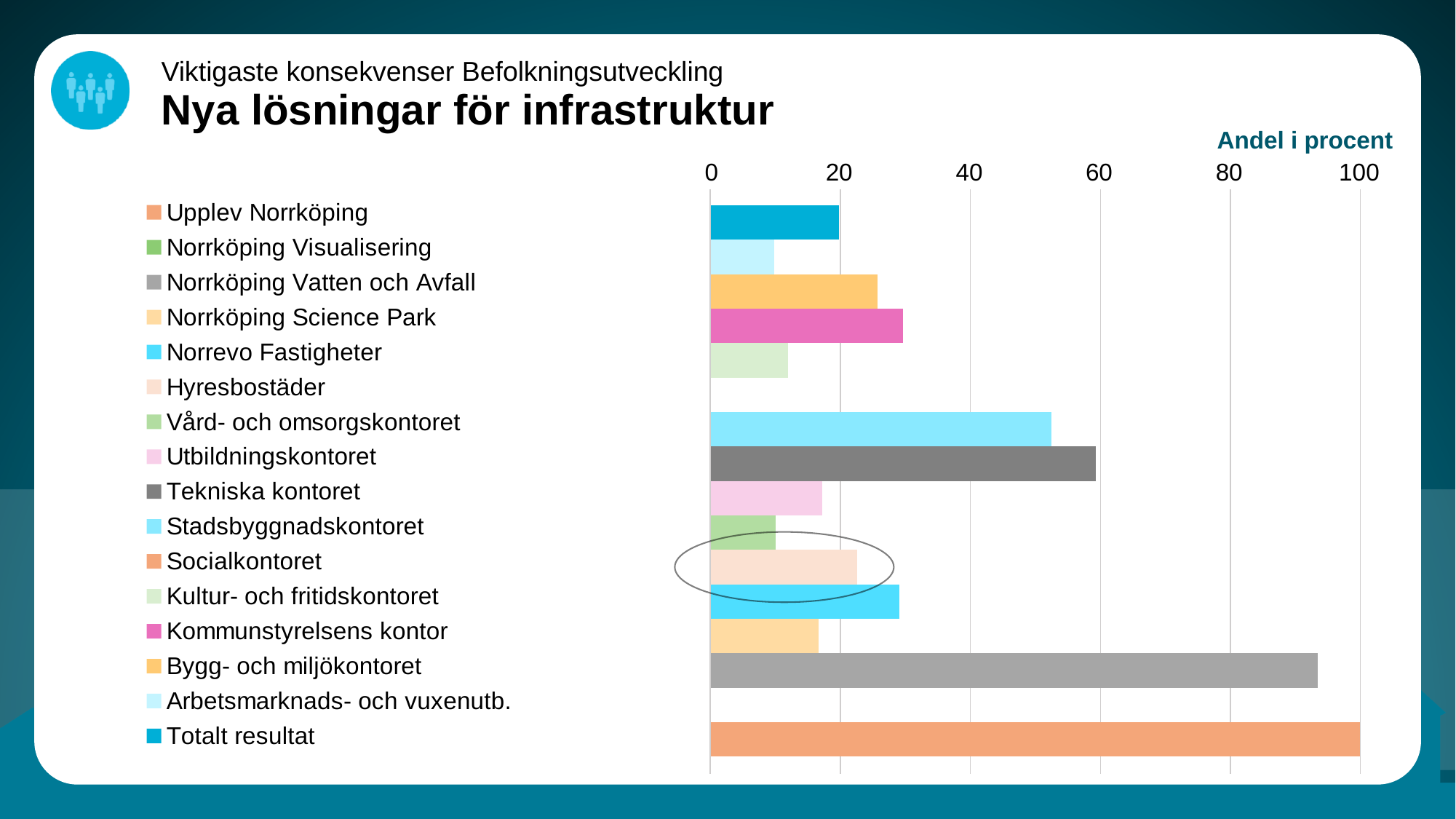
Is the value for Tekniska kontoret greater or less than 40? greater Which category has the highest value in the chart? Upplev Norrköping What kind of chart is shown on the slide? bar chart Which is larger, the value for Norrköping Vatten och Avfall or the value for Tekniska kontoret? Norrköping Vatten och Avfall Is the value for Norrköping Vatten och Avfall greater or less than 80? greater How many entries does the chart legend list? 16 What is the label shown above the horizontal axis of the chart? Andel i procent Which is larger, the value for Tekniska kontoret or the value for Stadsbyggnadskontoret? Tekniska kontoret Which is larger, the value for Kommunstyrelsens kontor or the value for Kultur- och fritidskontoret? Kommunstyrelsens kontor Is the value for Arbetsmarknads- och vuxenutb. greater or less than 20? less What is the value for Upplev Norrköping? 100